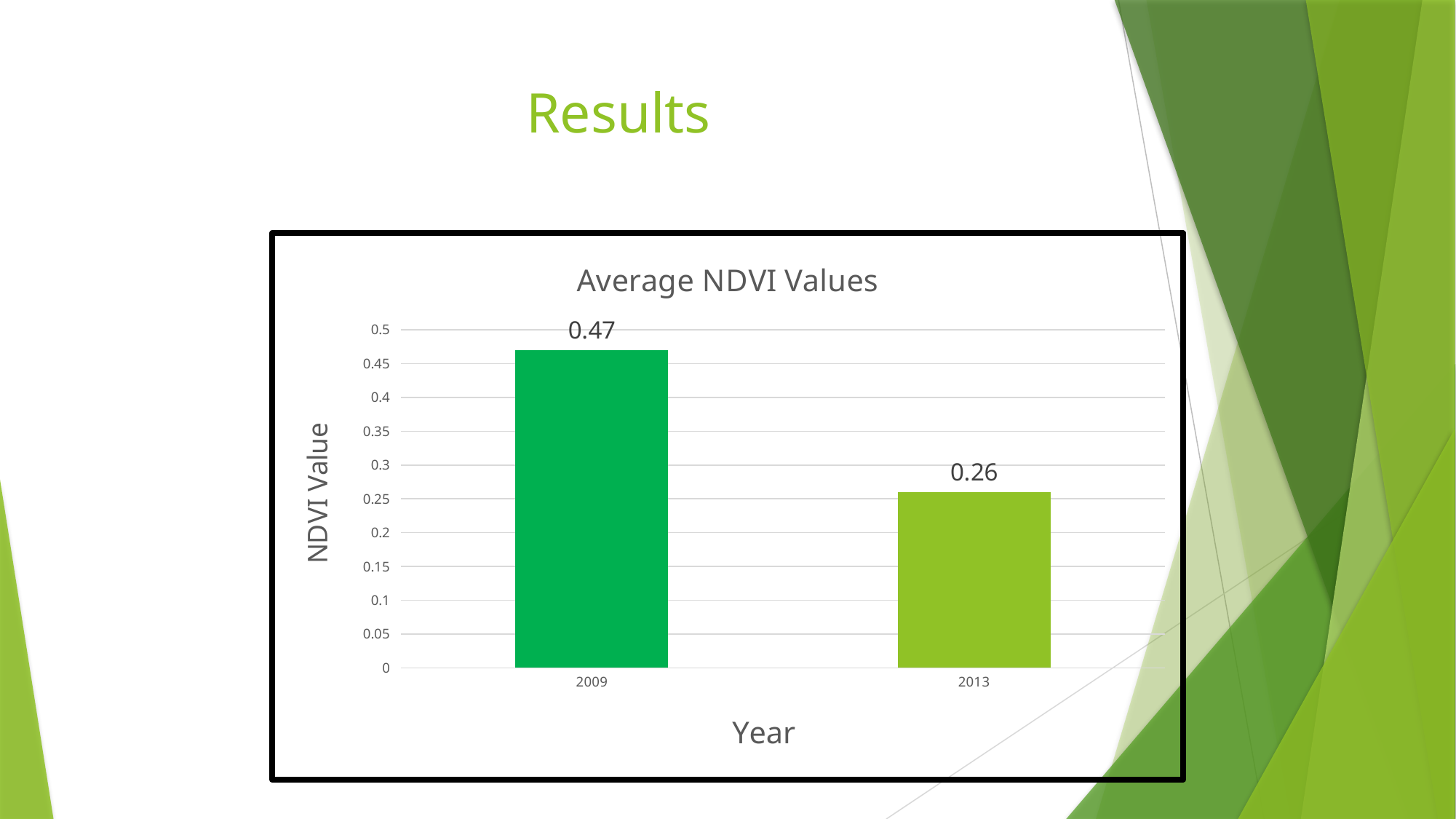
How many years are shown on the chart? 2 What is the average NDVI value for 2009? 0.47 What is the title of the chart? Average NDVI Values What kind of chart is shown on the slide? bar chart Which year has the highest average NDVI value? 2009 Is the average NDVI value for 2013 greater or less than 0.3? less Is the average NDVI value for 2009 greater or less than 0.4? greater What is the average NDVI value for 2013? 0.26 Which year has the lowest average NDVI value? 2013 Which is larger, the average NDVI value for 2009 or for 2013? 2009 Do the average NDVI values rise or fall from 2009 to 2013? fall What is the difference between the average NDVI values for 2009 and 2013? 0.21